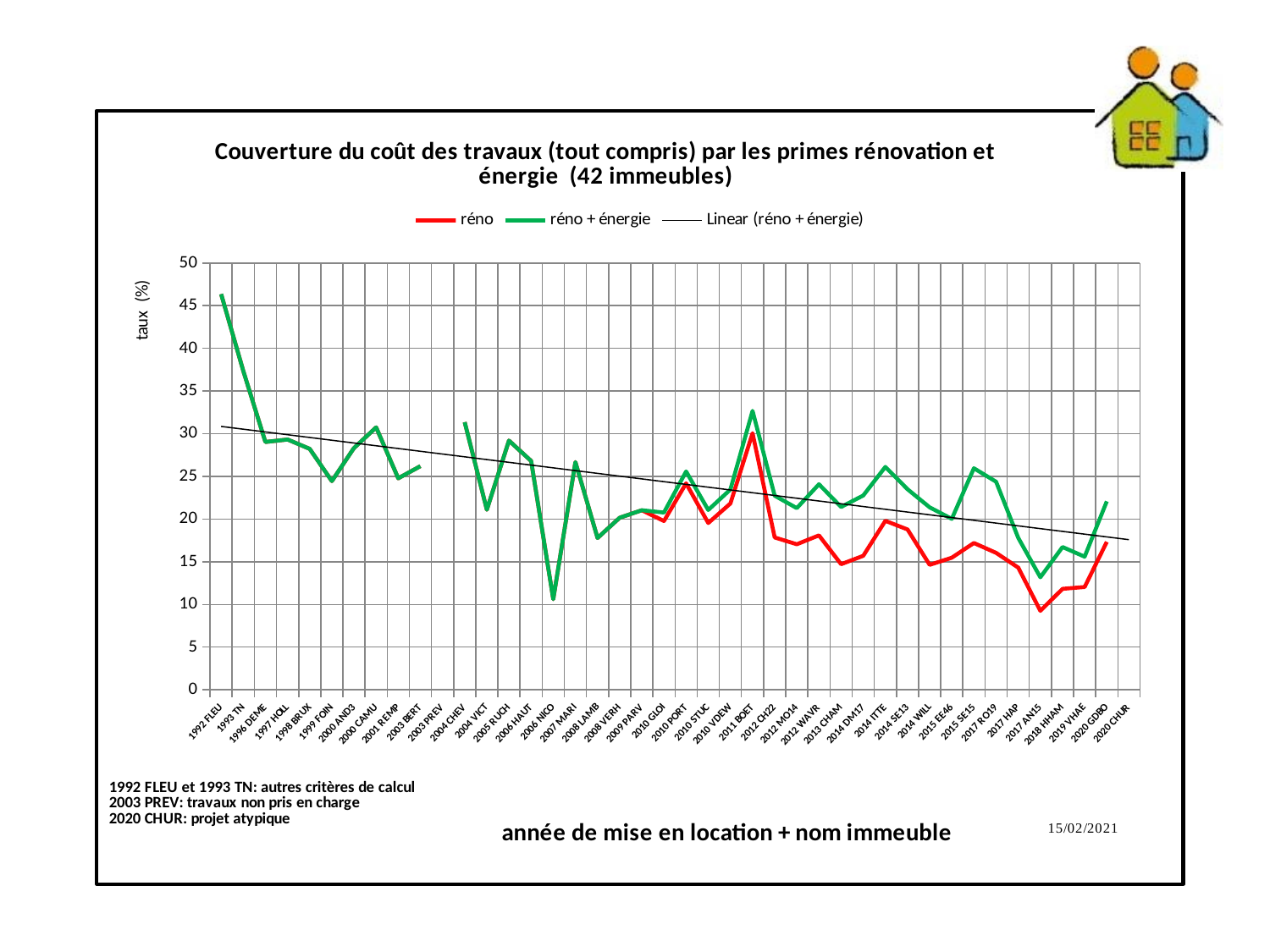
Is the 'réno' value for 2011 BOET greater or less than 25? greater How many series does the legend list? 3 How many buildings (categories) are plotted along the x axis? 42 Is the 'réno + énergie' value for 2006 NICO greater or less than 15? less Which building has the highest value for the 'réno + énergie' series? 1992 FLEU Which building has the lowest value for the 'réno' series? 2017 AN15 Is the 'réno + énergie' value for 1992 FLEU greater or less than 40? greater Which building has the lowest value for the 'réno + énergie' series? 2006 NICO What colour is the 'réno' series line? red Does the linear trendline for 'réno + énergie' rise or fall from left to right? fall What kind of chart is shown on the slide? line chart